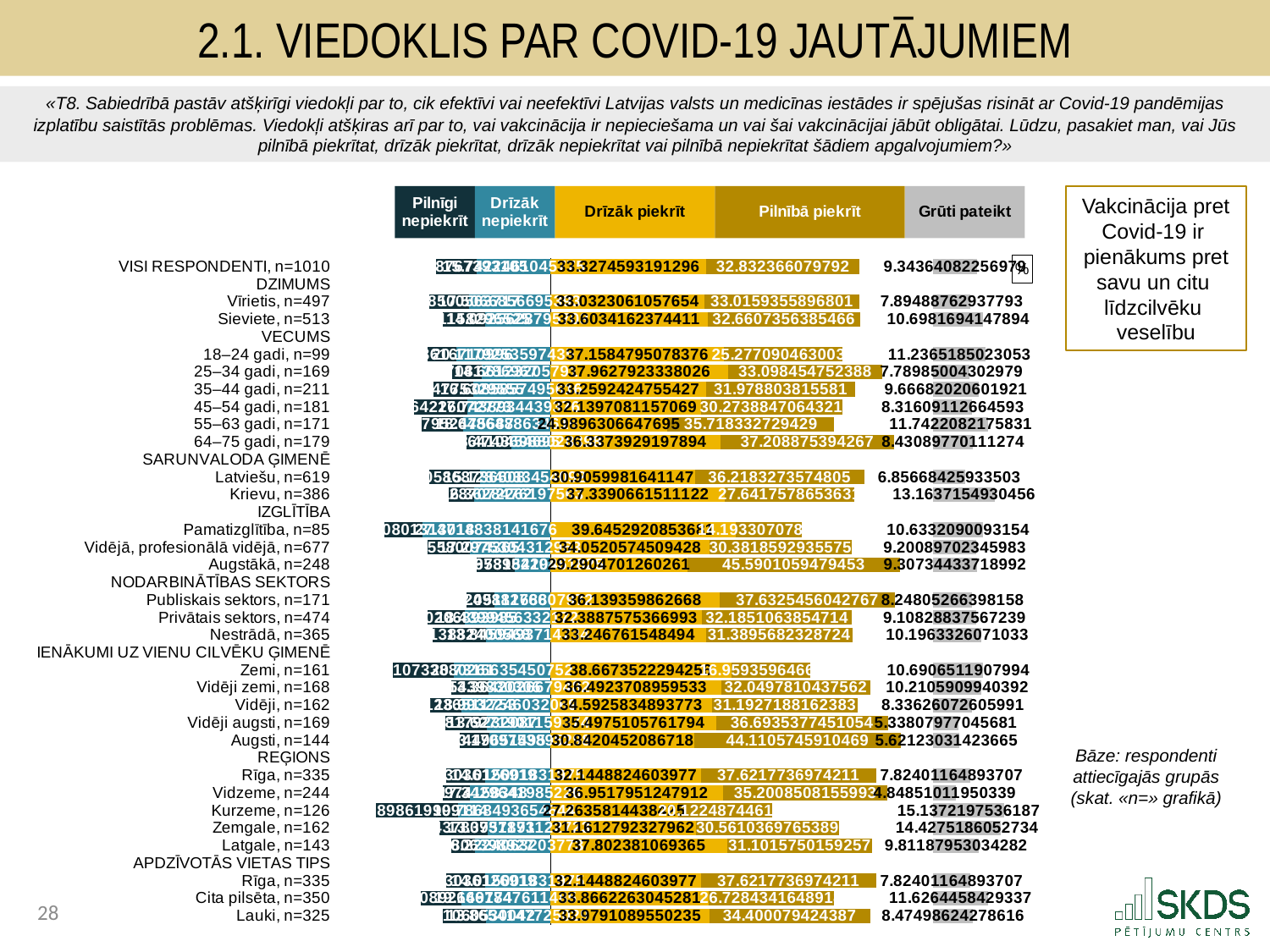
Which has the larger 'Pilnībā piekrīt' value, 'Latviešu, n=619' or 'Krievu, n=386'? Latviešu, n=619 What is the 'Pilnībā piekrīt' value for 'Augstākā, n=248'? 45.5901059479453 How many series does the chart legend list? 5 What is the 'Drīzāk piekrīt' value for 'Krievu, n=386'? 37.3390661511122 What statement is the chart about, according to the text box to the right of the chart? Vakcinācija pret Covid-19 ir pienākums pret savu un citu līdzcilvēku veselību What is the 'Pilnībā piekrīt' value for 'Augsti, n=144'? 44.1105745910469 What is the difference between the 'Grūti pateikt' values for 'Sieviete, n=513' and 'Vīrietis, n=497'? 2.80328178541147 Which region has the highest 'Grūti pateikt' value? Kurzeme, n=126 How many age groups (VECUMS) are shown in the chart? 6 What is the 'Grūti pateikt' value for 'Kurzeme, n=126'? 15.1372197536187 What kind of chart is shown on the slide? Bar chart (stacked horizontal) Which group has the highest 'Pilnībā piekrīt' value? Augstākā, n=248